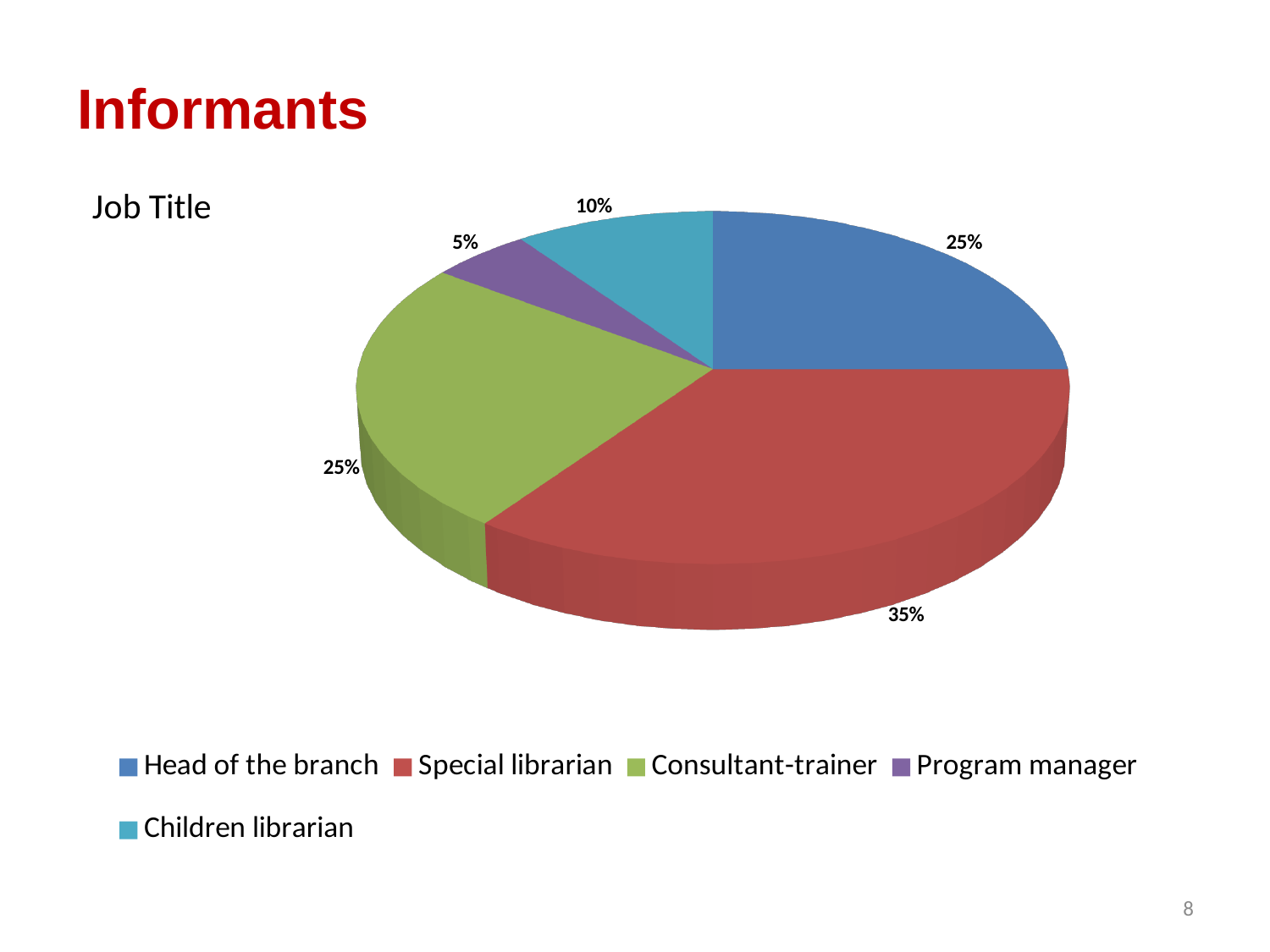
What is the value for Consultant-trainer? 25% What is the value for Head of the branch? 25% What is the title of the chart? Job Title What is the difference between the shares for Special librarian and Children librarian? 25% What share of the pie does Special librarian have? 35% Which job title has the smallest share of the pie? Program manager What share of the pie does Program manager have? 5% What kind of chart is shown on the slide? Pie chart Which is larger, the share for Children librarian or the share for Program manager? Children librarian How many job titles are shown in the pie chart? 5 What share of the pie does Children librarian have? 10% Which job title has the largest share of the pie? Special librarian